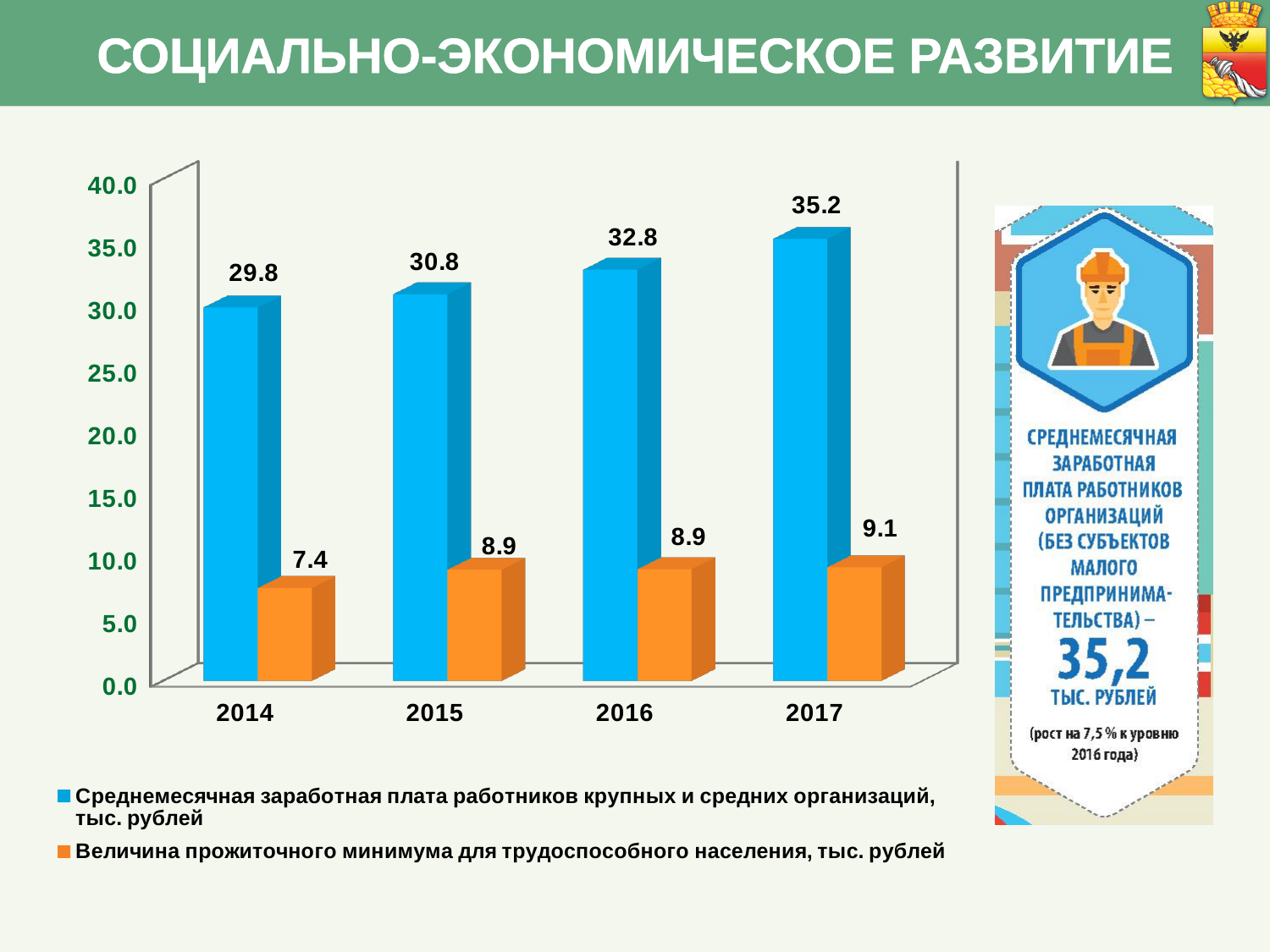
How many years are shown on the x axis of the chart? 4 What is the average monthly salary of employees of large and medium organisations (Среднемесячная заработная плата работников крупных и средних организаций) in 2017? 35.2 In which year is the subsistence minimum the lowest? 2014 By how much did the average monthly salary increase from 2016 to 2017? 2.4 How many series does the legend list? 2 Which is larger: the subsistence minimum in 2015 or in 2017? 2017 What is the subsistence minimum for the working-age population (Величина прожиточного минимума для трудоспособного населения) in 2014? 7.4 What is the average monthly salary value shown for 2015? 30.8 What kind of chart is shown on the slide? Bar chart What is the difference between the average monthly salary and the subsistence minimum in 2014? 22.4 Does the average monthly salary rise or fall from 2014 to 2017? Rises In which year is the average monthly salary the highest? 2017